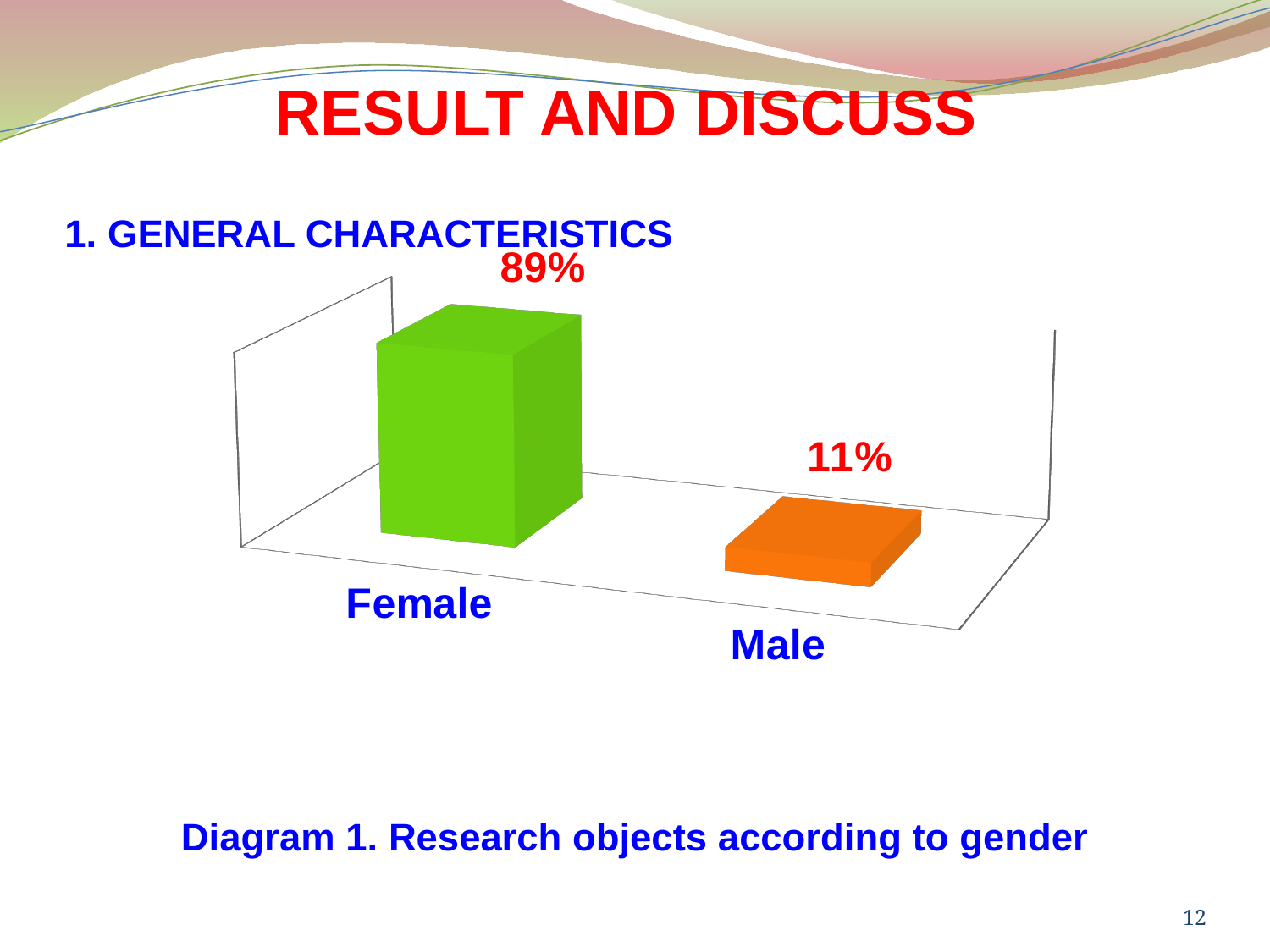
What is the difference between the Female and Male values? 78% What is the caption of the diagram shown on the slide? Diagram 1. Research objects according to gender Which category has the highest value? Female What kind of chart is shown on the slide? bar chart Which category has the lowest value? Male What is the value for Female? 89% What is the total of the Female and Male values? 100% How many categories are shown in the chart? 2 What is the value for Male? 11% Which is larger, the value for Female or the value for Male? Female What colour is the bar for Female? green